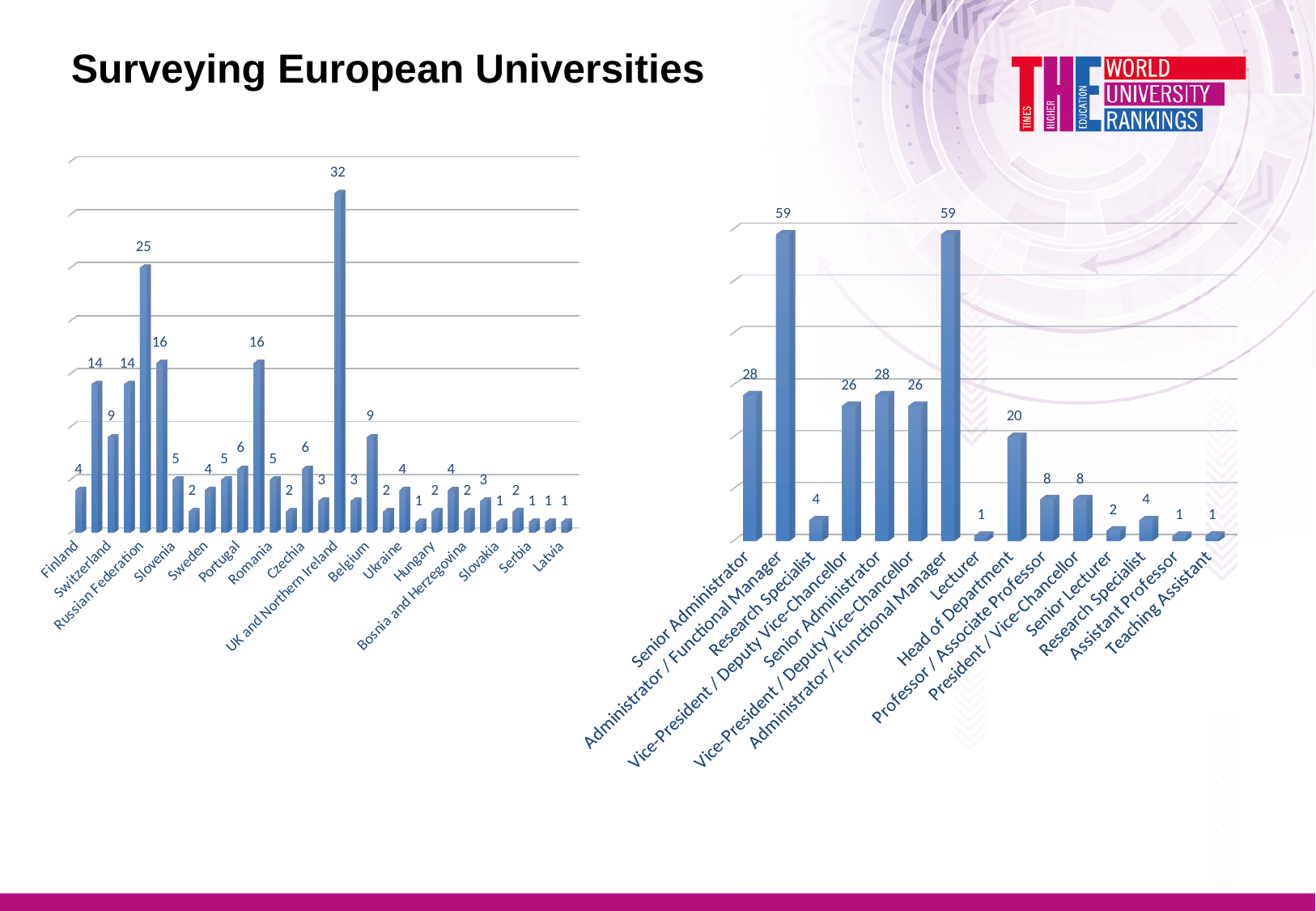
In the left-hand chart, which country has the highest value? UK and Northern Ireland In the left-hand chart, what is the value for UK and Northern Ireland? 32 In the right-hand chart, what is the difference between the values for Head of Department and Professor / Associate Professor? 12 In the right-hand chart, what is the value for Senior Lecturer? 2 In the right-hand chart, which is larger: the value for Senior Lecturer or the value for Research Specialist? Research Specialist In the right-hand chart, which category has the highest value? Administrator / Functional Manager In the right-hand chart, what is the value for Head of Department? 20 In the left-hand chart, what is the value for Russian Federation? 25 In the left-hand chart, what is the difference between the values for UK and Northern Ireland and Russian Federation? 7 In the right-hand chart, what is the value for Teaching Assistant? 1 What kind of chart is the right-hand chart? Bar chart What is the title of the slide? Surveying European Universities